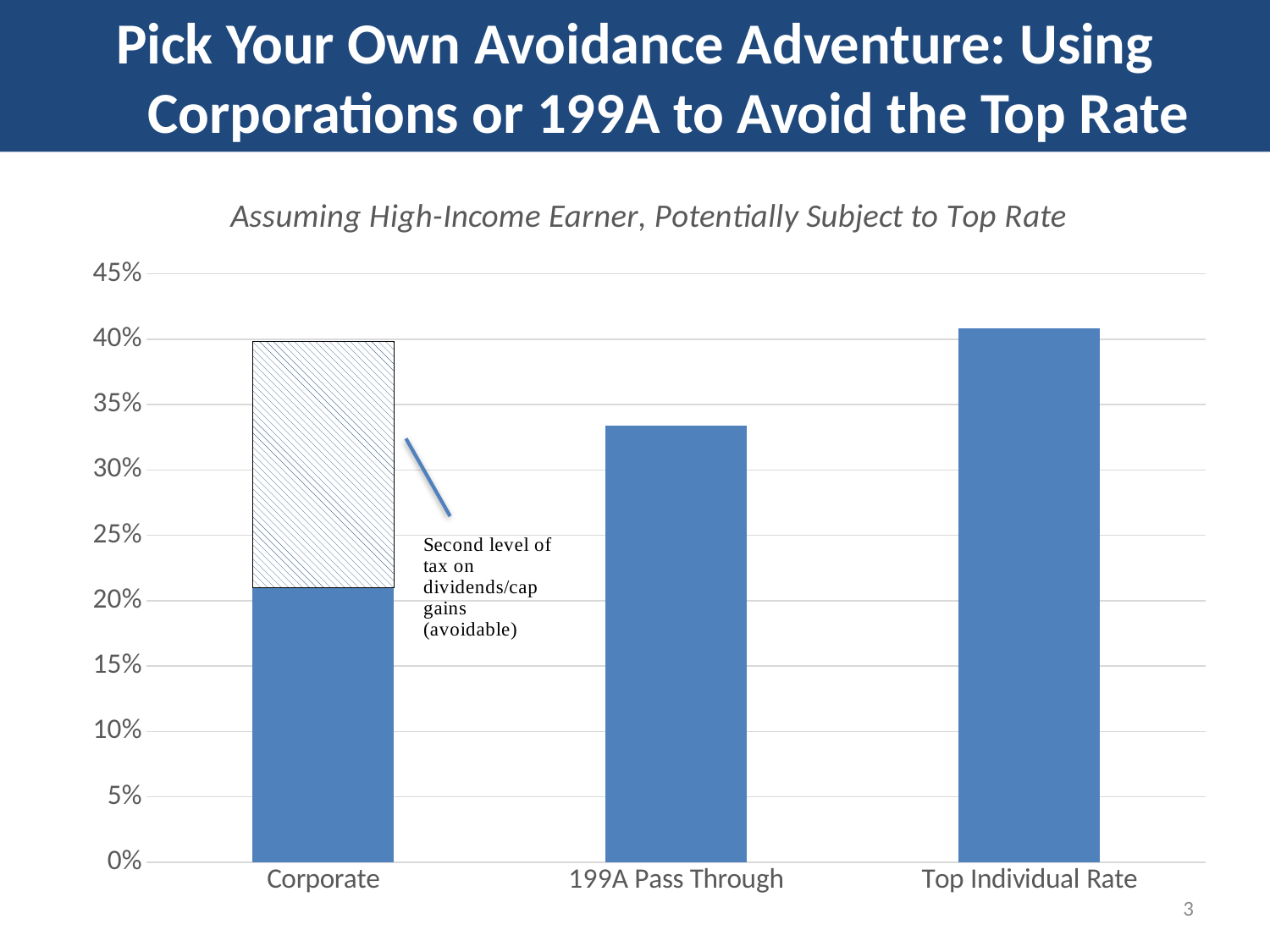
What does the annotation next to the hatched portion of the Corporate bar say? Second level of tax on dividends/cap gains (avoidable) What is the highest value shown on the y axis? 45% What is the title of the chart? Assuming High-Income Earner, Potentially Subject to Top Rate How many categories are shown on the x axis of the chart? 3 Is the value for 199A Pass Through greater or less than 35%? less Is the solid blue portion of the Corporate bar greater or less than 25%? less What kind of chart is shown on the slide? bar chart Which category has the lowest solid blue bar? Corporate Which is larger, the value for 199A Pass Through or the value for Top Individual Rate? Top Individual Rate Is the value for 199A Pass Through greater or less than 30%? greater Which is larger, the solid blue portion of the Corporate bar or the 199A Pass Through bar? 199A Pass Through